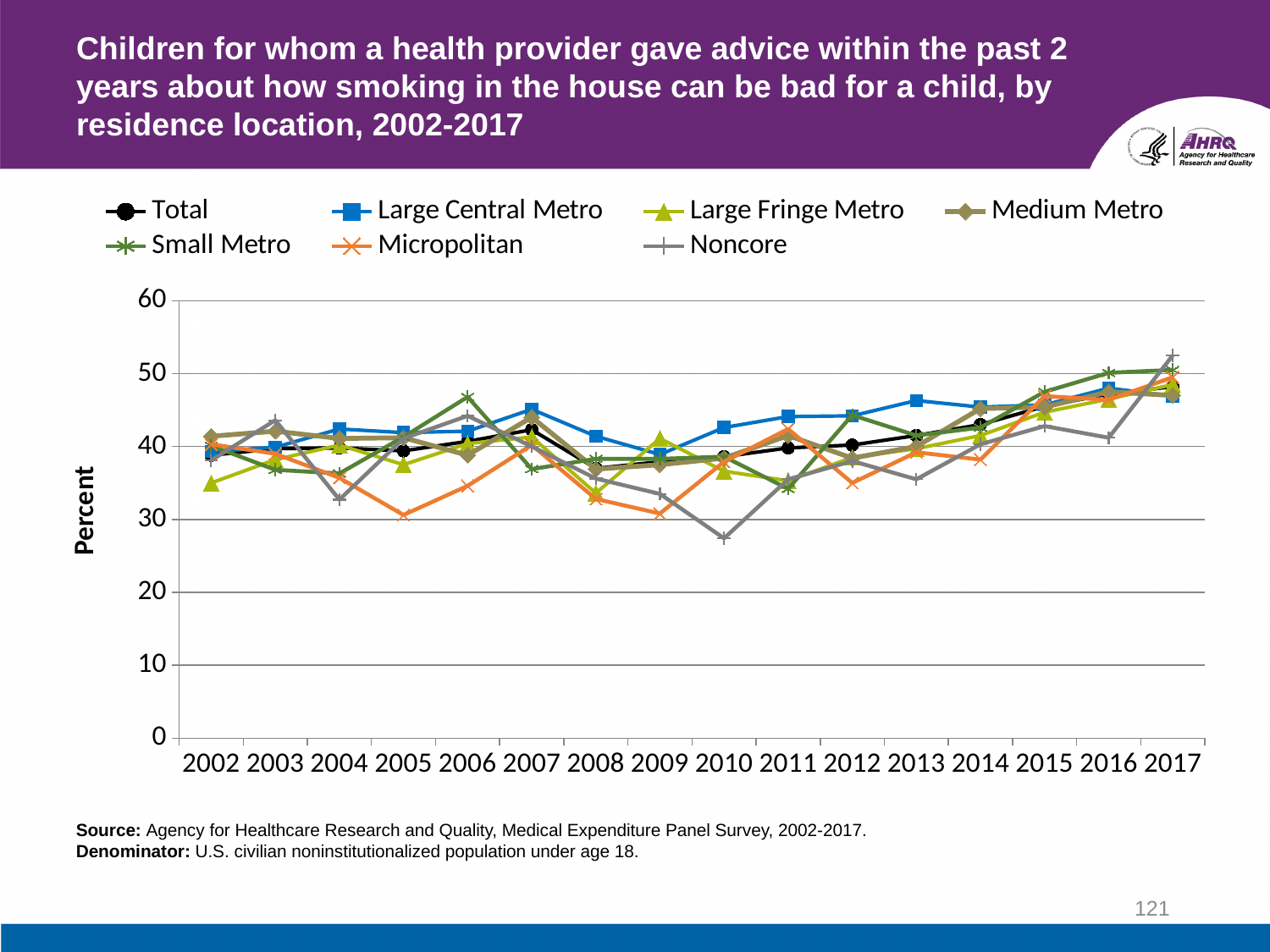
Is the value for Large Central Metro in 2013 greater or less than 40? greater Which series has the lowest value in 2010? Noncore Does the Total series rise or fall overall from 2002 to 2017? rise What kind of chart is shown on the slide? line chart In which year does the Noncore series reach its lowest value? 2010 What is the label on the vertical axis? Percent Is the value for Noncore in 2010 greater or less than 30? less How many series does the legend list? 7 Is the value for Large Fringe Metro in 2002 greater or less than 40? less In 2005, which is larger: Large Central Metro or Micropolitan? Large Central Metro How many years are shown along the x axis? 16